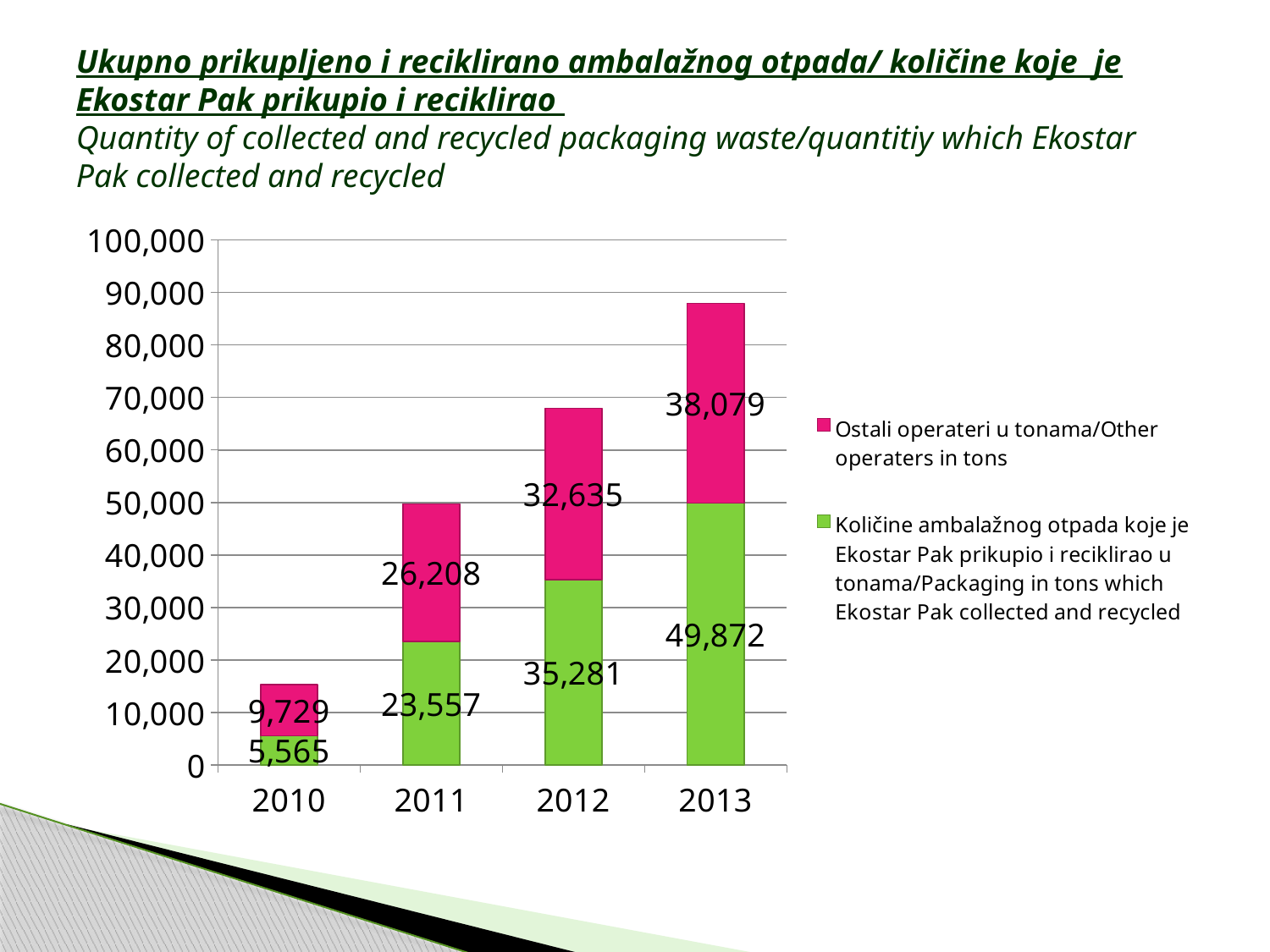
In 2012, which is larger: the Ekostar Pak value or the Other operators value? Ekostar Pak (35,281) What is the difference between the Ekostar Pak value and the Other operators value in 2013? 11,793 What is the total of the stacked bar for 2011? 49,765 What is the value for Ekostar Pak (green series) in 2013? 49,872 How many series does the chart's legend list? 2 How many years are shown on the x axis of the chart? 4 What kind of chart is shown on the slide? Stacked bar chart In which year is the Ekostar Pak (green series) value highest? 2013 What is the value for Ekostar Pak (green series) in 2010? 5,565 What is the value for Other operators (pink series) in 2011? 26,208 Does the Ekostar Pak (green series) value rise or fall from 2010 to 2013? Rise In which year is the Other operators (pink series) value lowest? 2010